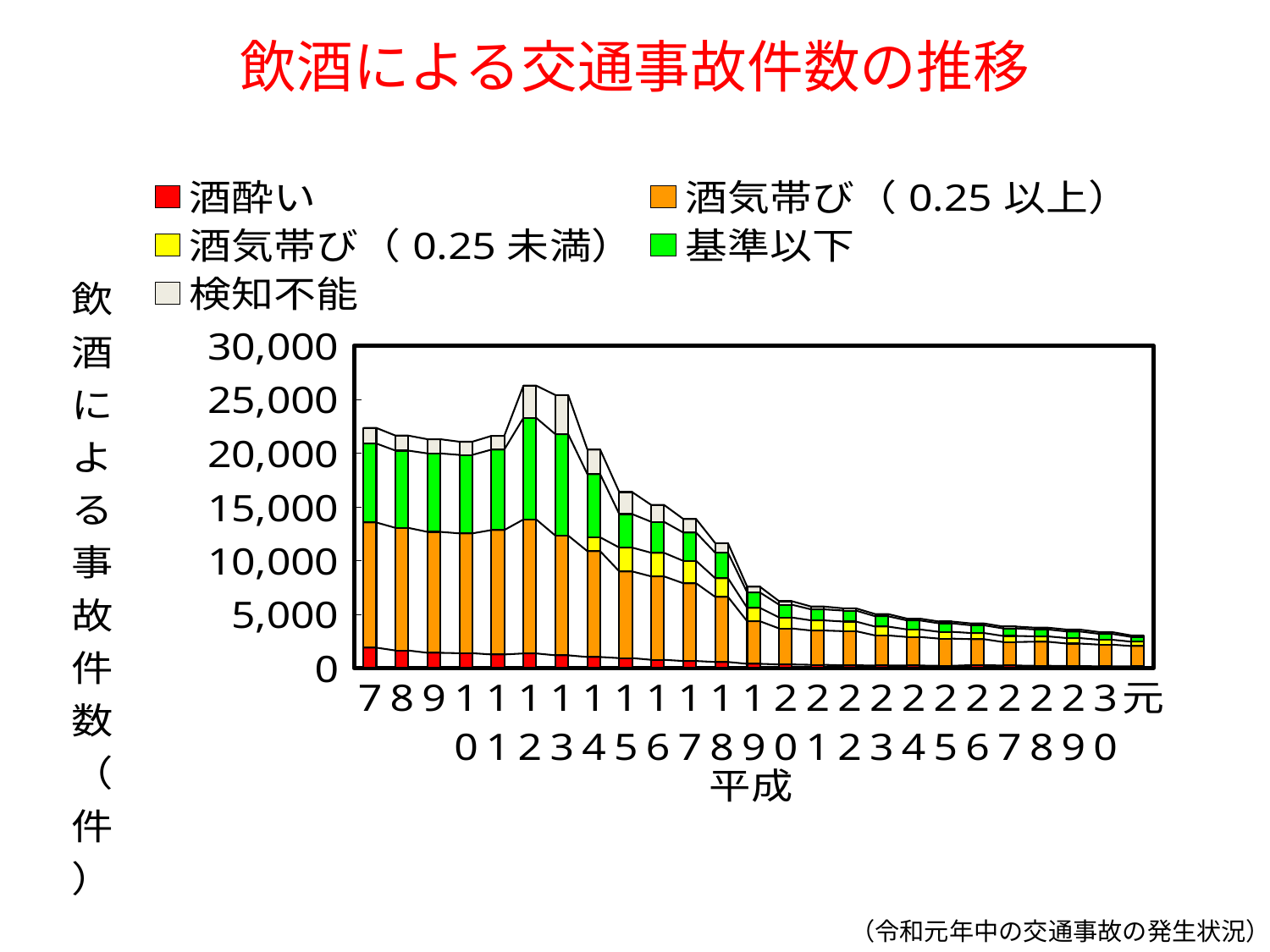
What kind of chart is shown on the slide? stacked bar chart What is the title of the chart? 飲酒による交通事故件数の推移 How many series does the legend list? 5 Overall, do the totals rise or fall from 平成12 to 令和元? fall Is the total for 平成7 greater or less than 20,000? greater Which has a larger total, 平成12 or 平成20? 平成12 Is the total for 平成12 greater or less than 25,000? greater Is the total for 平成20 greater or less than 10,000? less Which colour represents 酒酔い in the legend? red How many year categories are plotted along the x axis? 25 Which year has the highest total number of drunk-driving accidents? 平成12